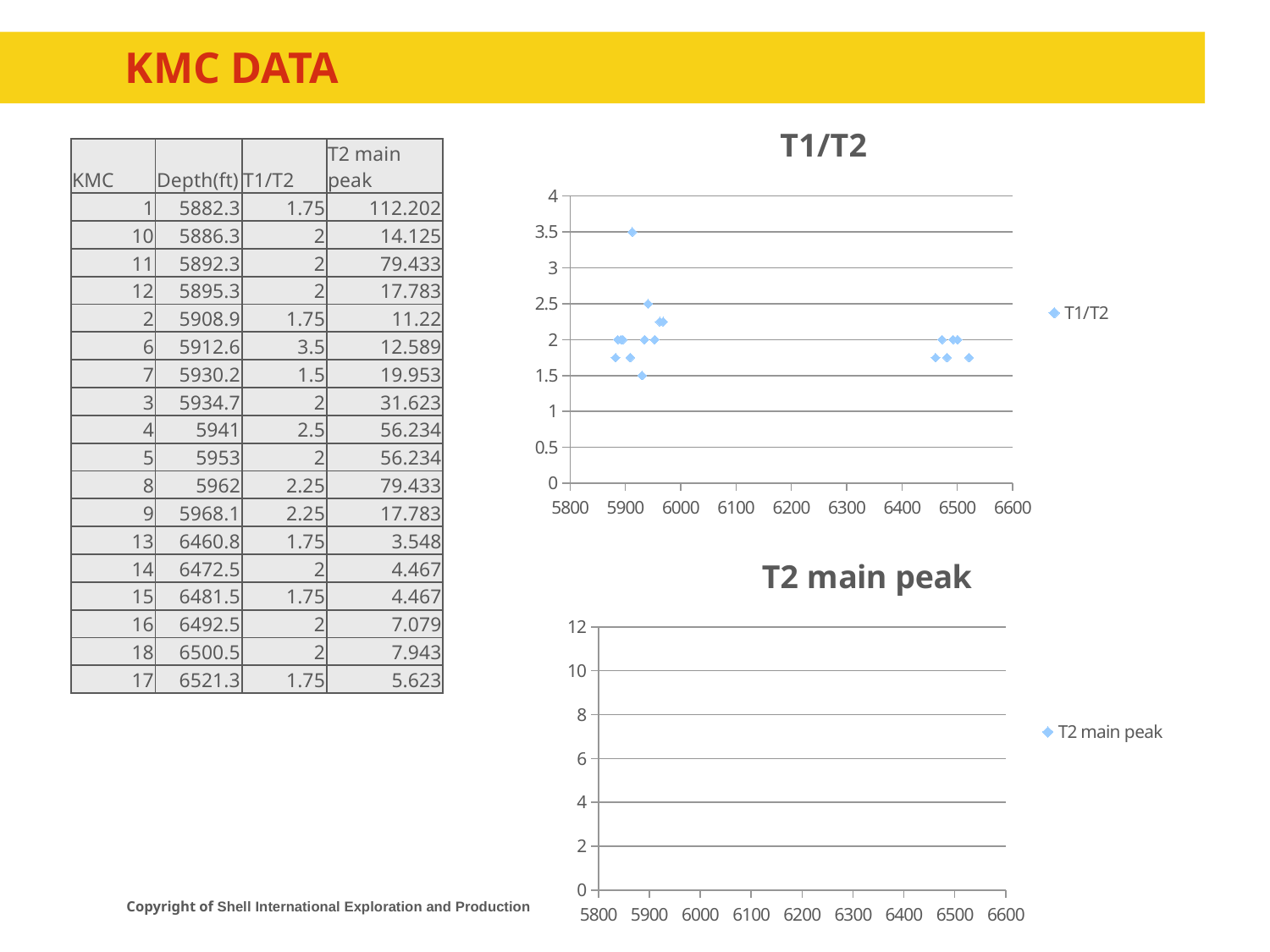
In the T1/T2 chart, what is the highest T1/T2 value plotted? 3.5 What is the maximum value shown on the vertical axis of the T2 main peak chart? 12 According to the table, what is the T1/T2 value at depth 5941 ft? 2.5 What kind of chart is the T2 main peak chart? scatter chart How many series does the legend of the T1/T2 chart list? 1 In the T1/T2 chart, are the points plotted between depths 6400 and 6600 greater or less than 2.5? less In the T1/T2 chart, is the highest plotted point greater or less than 3? greater What is the title of the lower chart on the slide? T2 main peak What kind of chart is the T1/T2 chart? scatter chart In the T1/T2 chart, what is the lowest T1/T2 value plotted? 1.5 According to the table, what is the T1/T2 value for KMC 6, the highest point in the T1/T2 chart? 3.5 How many series does the legend of the T2 main peak chart list? 1